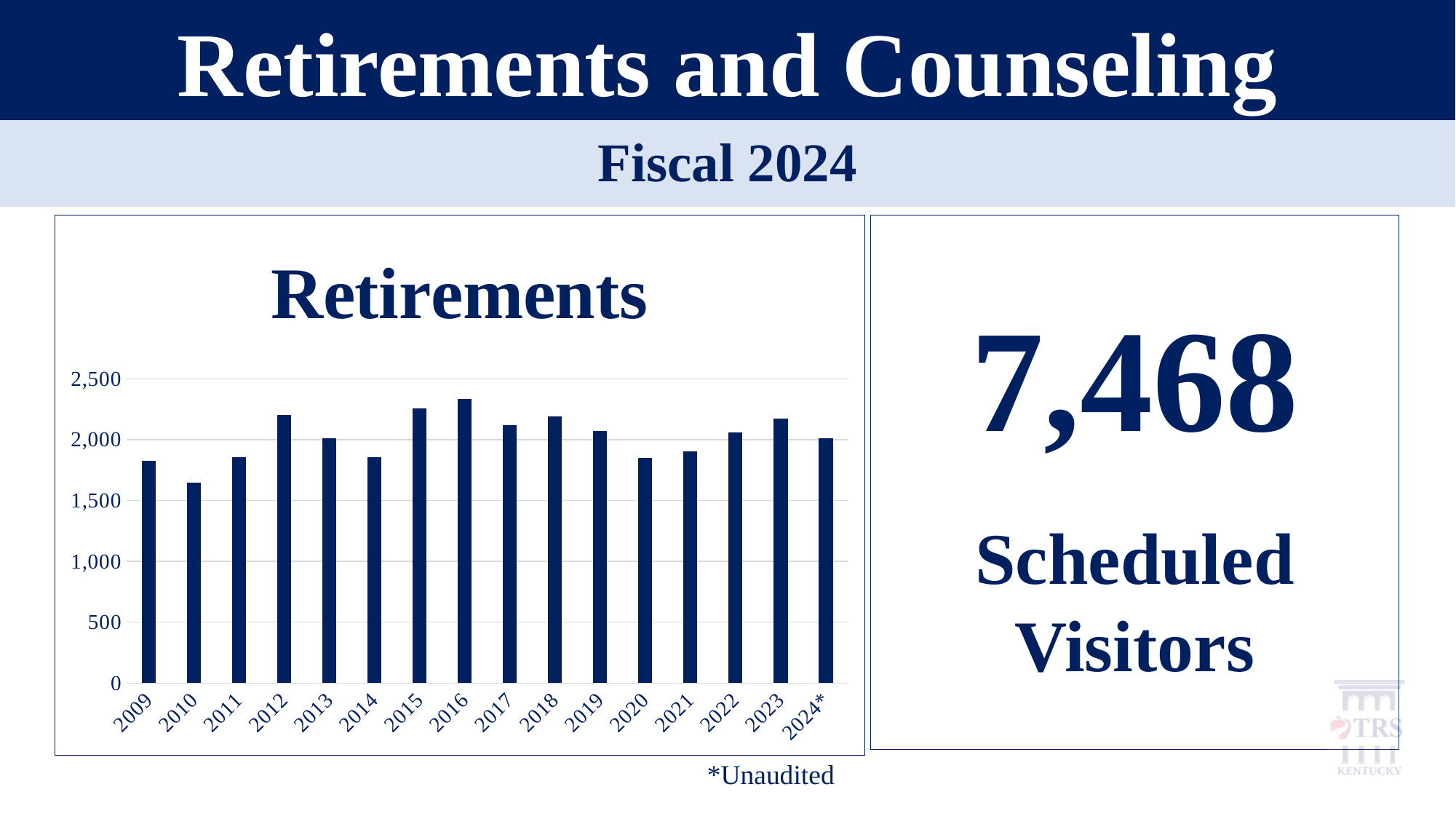
In the Retirements chart, which year has more retirements, 2015 or 2020? 2015 What does the asterisk on the 2024 label in the Retirements chart indicate, according to the footnote? Unaudited In the Retirements chart, is the value for 2010 greater or less than 2,000? less Which year has the highest number of retirements in the Retirements chart? 2016 Which year has the lowest number of retirements in the Retirements chart? 2010 In the Retirements chart, is the value for 2020 greater or less than 2,000? less In the Retirements chart, which year has more retirements, 2012 or 2014? 2012 In the Retirements chart, is the value for 2016 greater or less than 2,000? greater How many years are shown on the x axis of the Retirements chart? 16 What kind of chart is the Retirements chart? bar chart